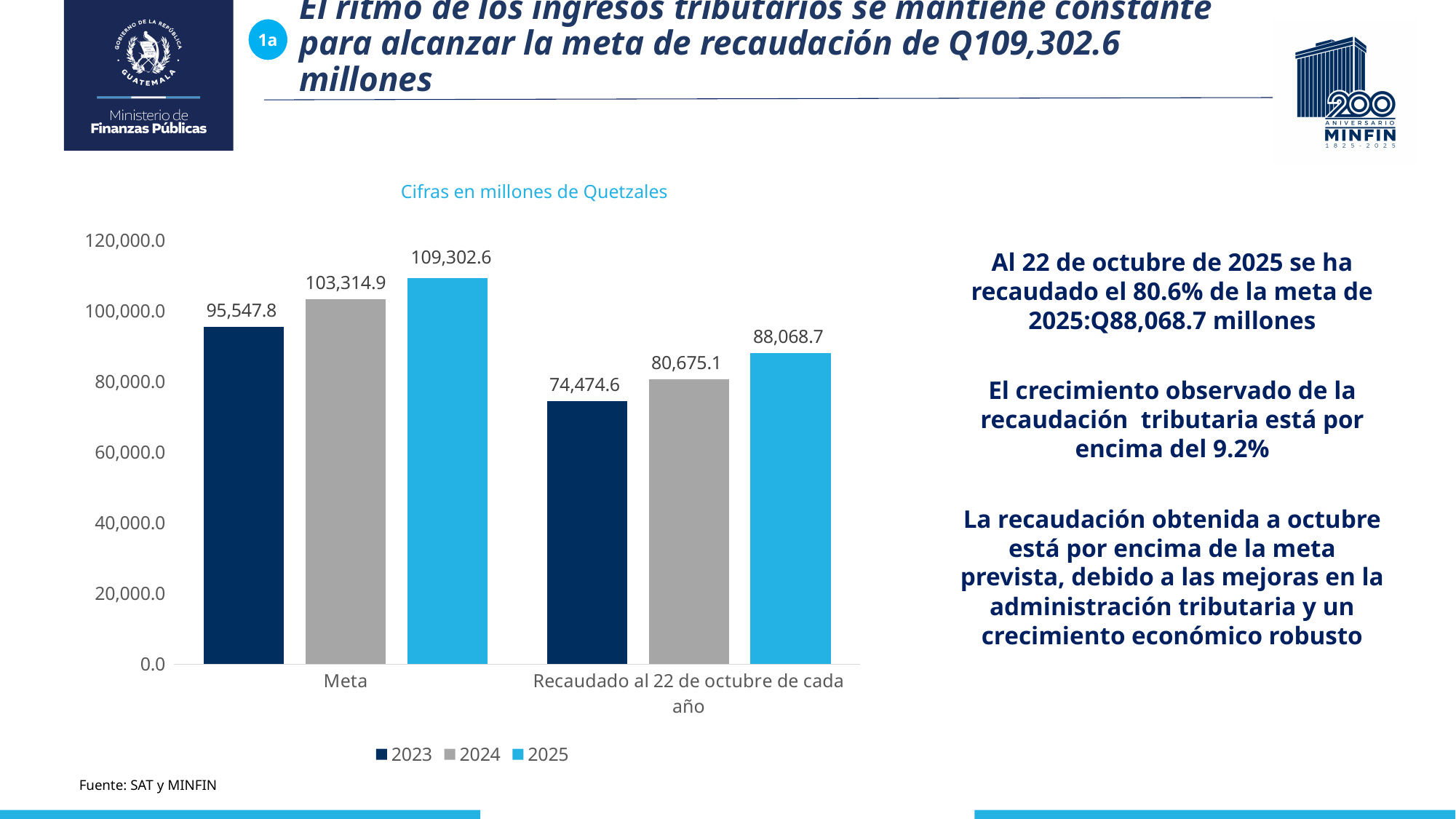
What is the subtitle shown above the chart? Cifras en millones de Quetzales How many series does the legend list? 3 What kind of chart is shown on the slide? Bar chart Which year has the lowest value in the 'Recaudado al 22 de octubre de cada año' category? 2023 What is the difference between the 2025 Meta value and the 2025 'Recaudado al 22 de octubre de cada año' value? 21,233.9 What is the value of the 2025 bar for the Meta category? 109,302.6 What is the value of the 2025 bar for 'Recaudado al 22 de octubre de cada año'? 88,068.7 Which is larger: the 2024 Meta value or the 2023 Meta value? 2024 Meta value Is the 2024 value for 'Recaudado al 22 de octubre de cada año' greater or less than 100,000.0? less Which year has the highest value in the Meta category? 2025 What is the value of the 2024 bar for the Meta category? 103,314.9 What is the value of the 2023 bar for 'Recaudado al 22 de octubre de cada año'? 74,474.6